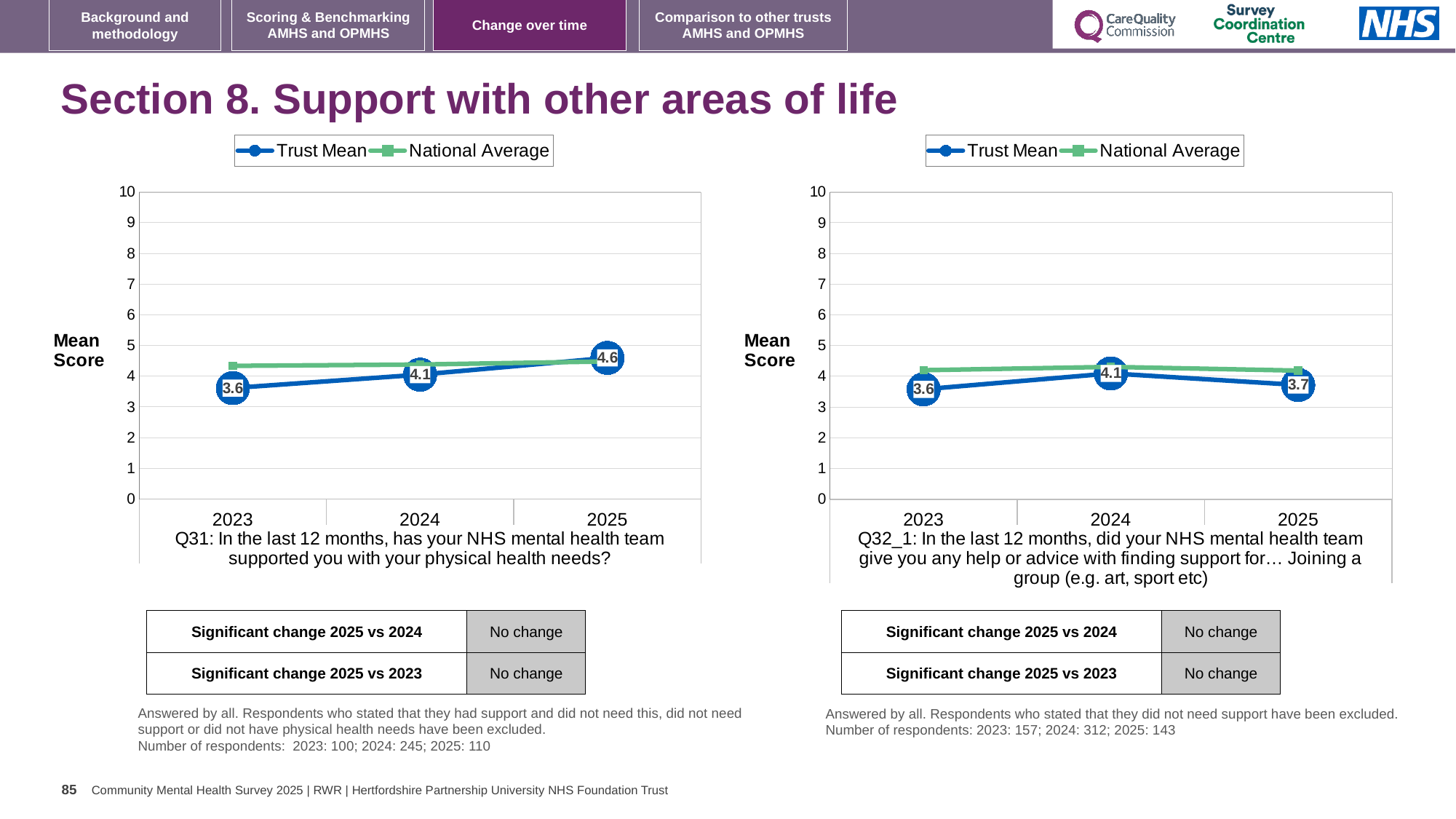
On the right chart (Q32_1), what is the Trust Mean for 2025? 3.7 On the left chart (Q31), is the National Average for 2023 greater or less than 3? greater On the right chart (Q32_1), what is the Trust Mean for 2024? 4.1 How many series does the legend of the right chart (Q32_1) list? 2 On the right chart (Q32_1), which year has the lowest Trust Mean? 2023 On the right chart (Q32_1), is the Trust Mean higher in 2024 or in 2025? 2024 On the left chart (Q31), does the Trust Mean rise or fall from 2023 to 2025? rise What type of chart is the left chart (Q31)? line chart On the left chart (Q31), what is the Trust Mean for 2023? 3.6 On the left chart (Q31), what is the difference between the Trust Mean in 2025 and in 2023? 1.0 On the left chart (Q31), what is the Trust Mean for 2025? 4.6 On the left chart (Q31), which year has the highest Trust Mean? 2025